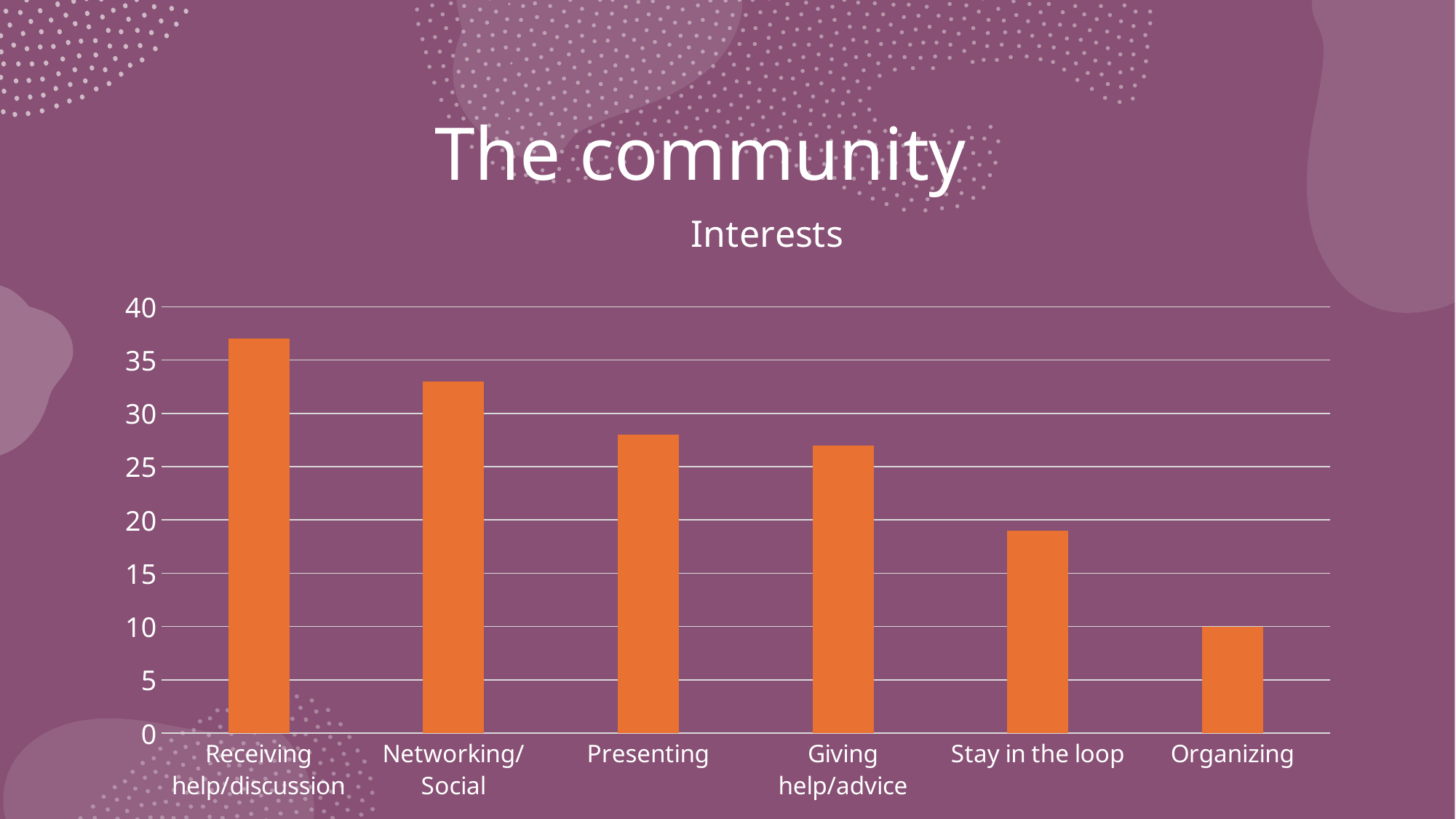
What kind of chart is shown on the slide? bar chart Which category has the highest value? Receiving help/discussion What is the title of the chart? Interests Is the value for Stay in the loop greater or less than 20? less Do the values rise or fall from left to right along the x axis? fall Is the value for Networking/Social greater or less than 35? less Is the value for Receiving help/discussion greater or less than 35? greater Which is larger, the value for Networking/Social or the value for Stay in the loop? Networking/Social How many categories are shown on the x axis of the chart? 6 Which category has the lowest value? Organizing